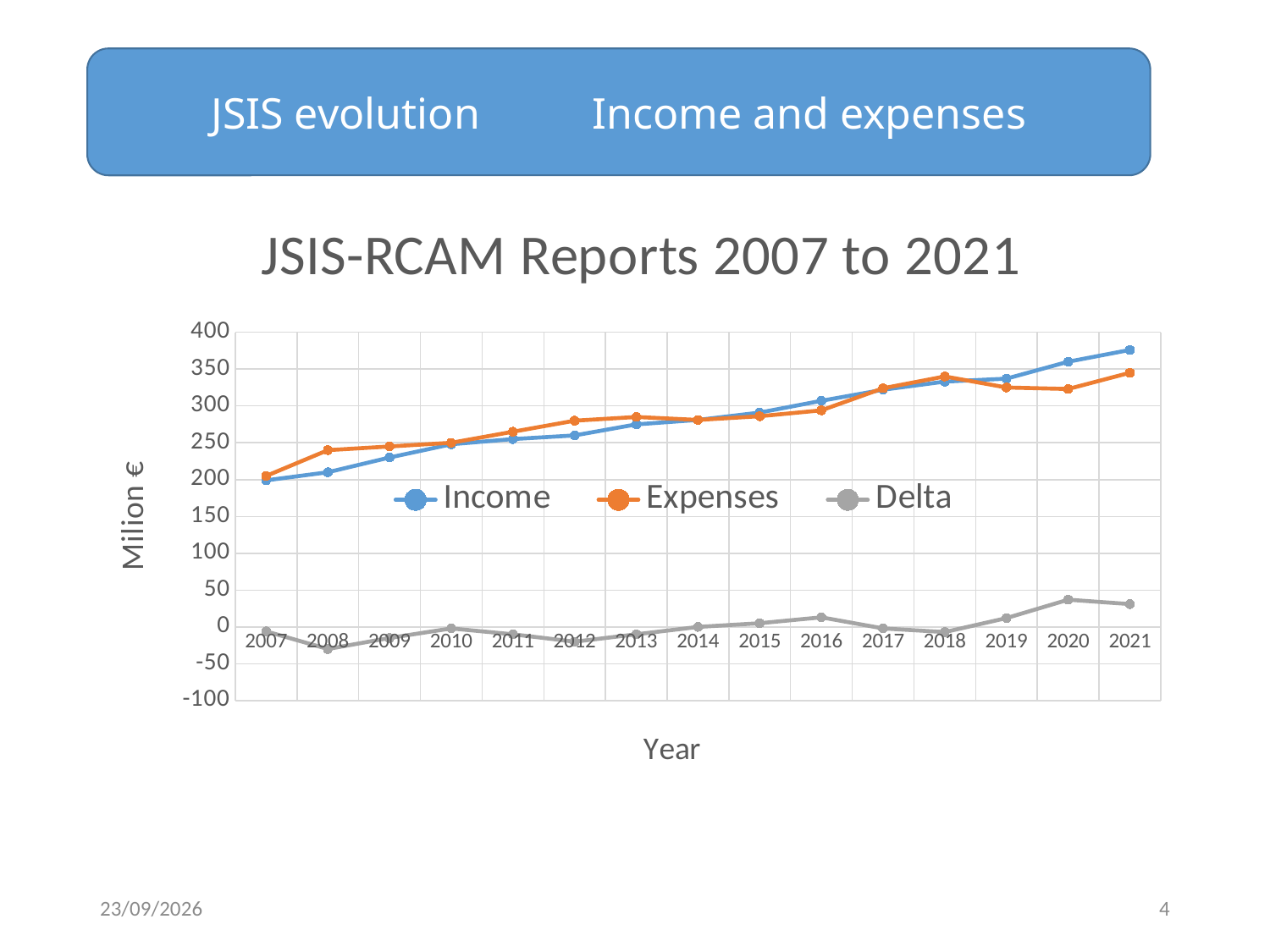
What is the title of the chart? JSIS-RCAM Reports 2007 to 2021 How many years are plotted along the x axis? 15 What is the label on the vertical axis? Milion € In which year is Delta at its lowest? 2008 What kind of chart is shown on the slide? line chart In which year is Income at its lowest? 2007 Does the Income series generally rise or fall from 2007 to 2021? rise How many series does the legend list? 3 In which year is Income at its highest? 2021 In 2021, which is larger, Income or Expenses? Income In 2008, which is larger, Income or Expenses? Expenses Is the value for Income in 2021 greater or less than 350? greater